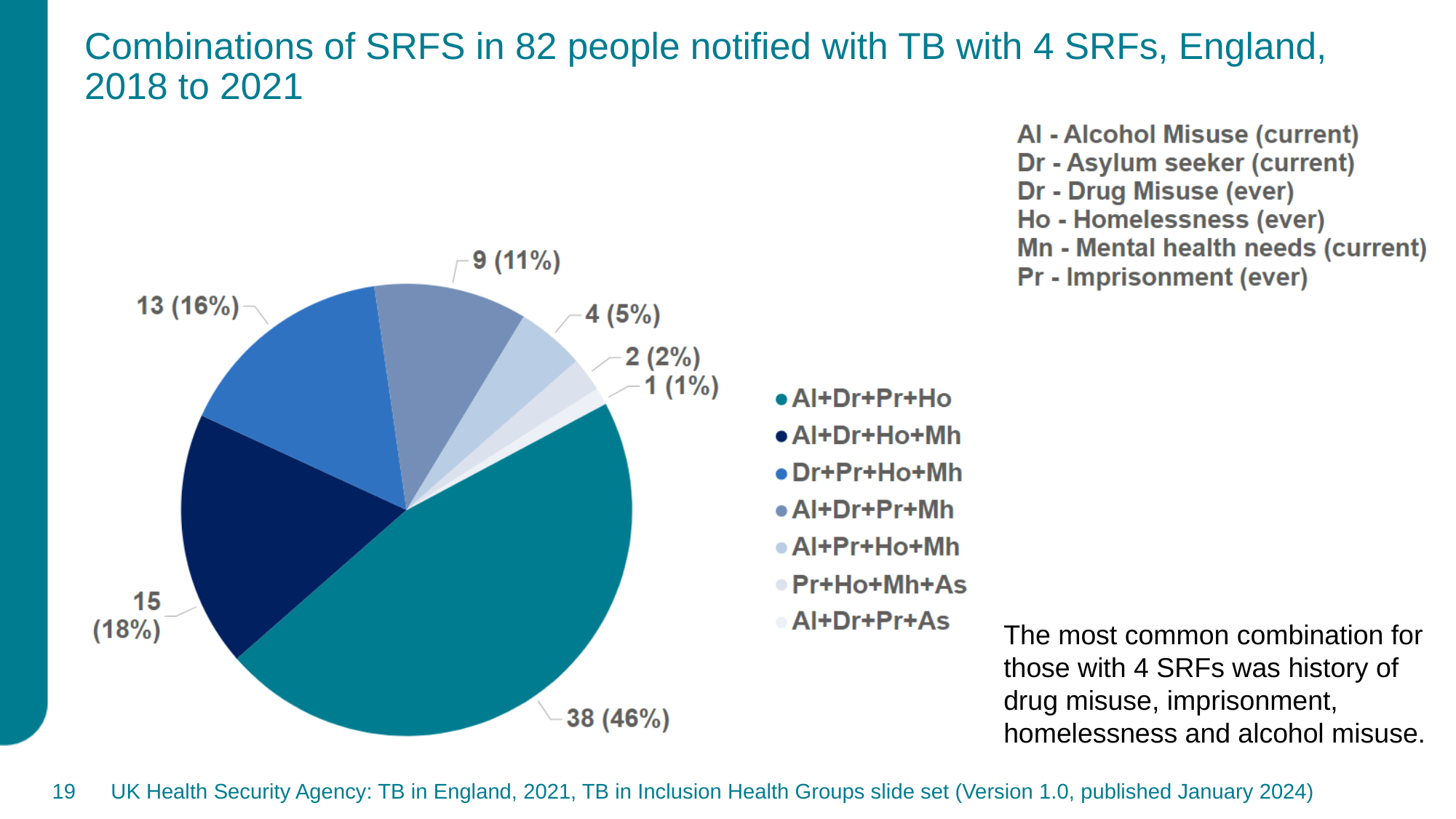
What is the difference in number of people between the Al+Dr+Pr+Ho slice and the Al+Dr+Ho+Mh slice? 23 How many entries does the legend of the pie chart list? 7 Which combination has the largest slice of the pie? Al+Dr+Pr+Ho What percentage share does the Al+Dr+Pr+Ho slice have? 46% What is the percentage share of the Pr+Ho+Mh+As slice? 2% How many people are in the Al+Dr+Ho+Mh slice? 15 Which slice is larger, Al+Dr+Pr+Mh or Al+Pr+Ho+Mh? Al+Dr+Pr+Mh What percentage share does the Dr+Pr+Ho+Mh slice have? 16% What kind of chart is shown on the slide? Pie chart Which combination has the smallest slice of the pie? Al+Dr+Pr+As How many slices does the pie chart have? 7 How many people are in the Al+Dr+Pr+Ho slice? 38